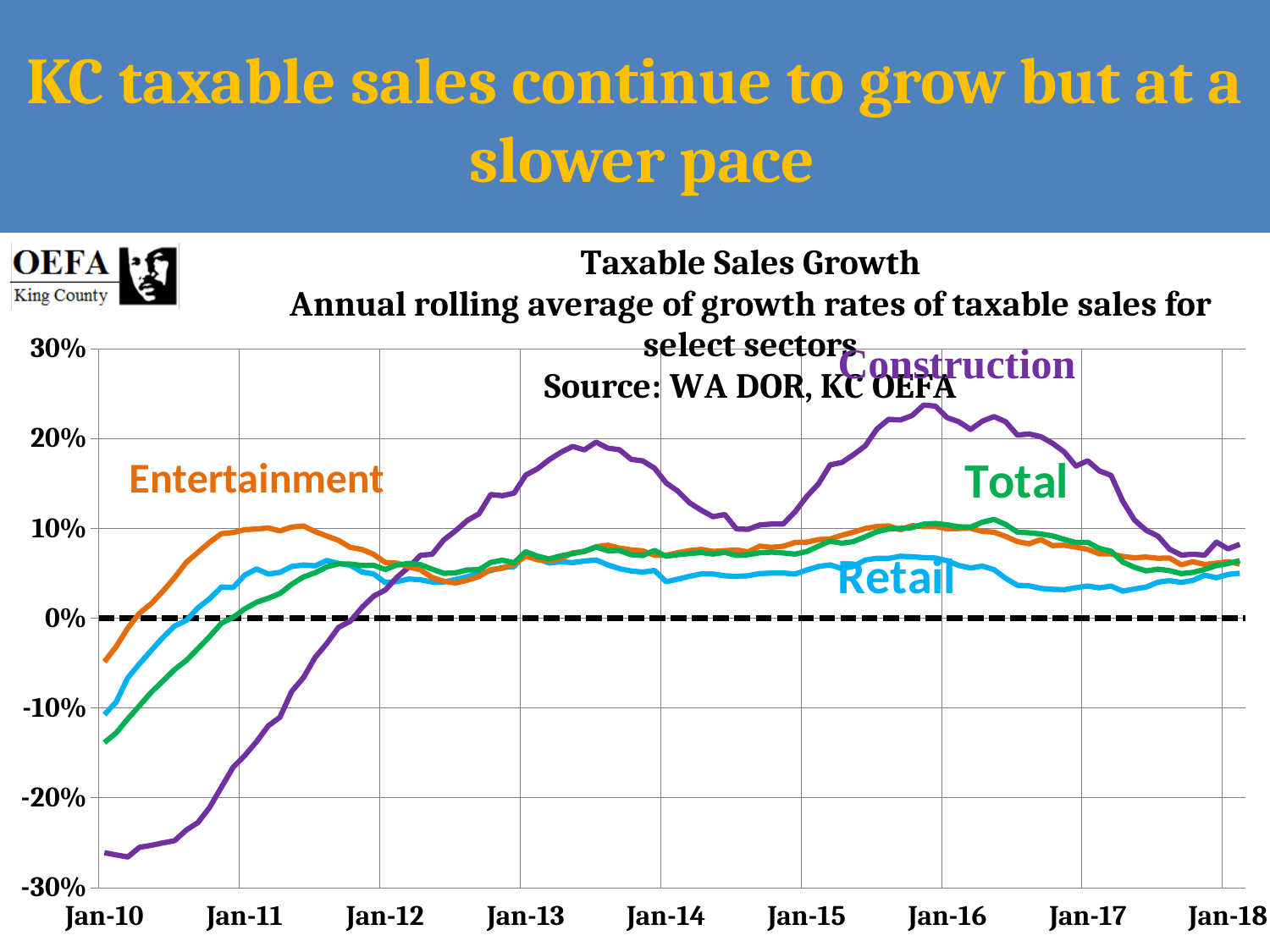
Is the value for Retail at Jan-17 greater or less than 0%? greater Is the value for Construction at Jan-16 greater or less than 20%? greater What kind of chart is shown on the slide? Line chart Is the value for Construction at Jan-10 greater or less than -20%? less Which series is highest at Jan-16? Construction How many year labels are shown on the x axis? 9 How many series are plotted on the chart? 4 Does the Construction line rise or fall between Jan-16 and Jan-18? Fall What source is cited for the chart data? WA DOR, KC OEFA Which series is lowest at Jan-10? Construction At Jan-10, which is larger: the value for Entertainment or the value for Construction? Entertainment